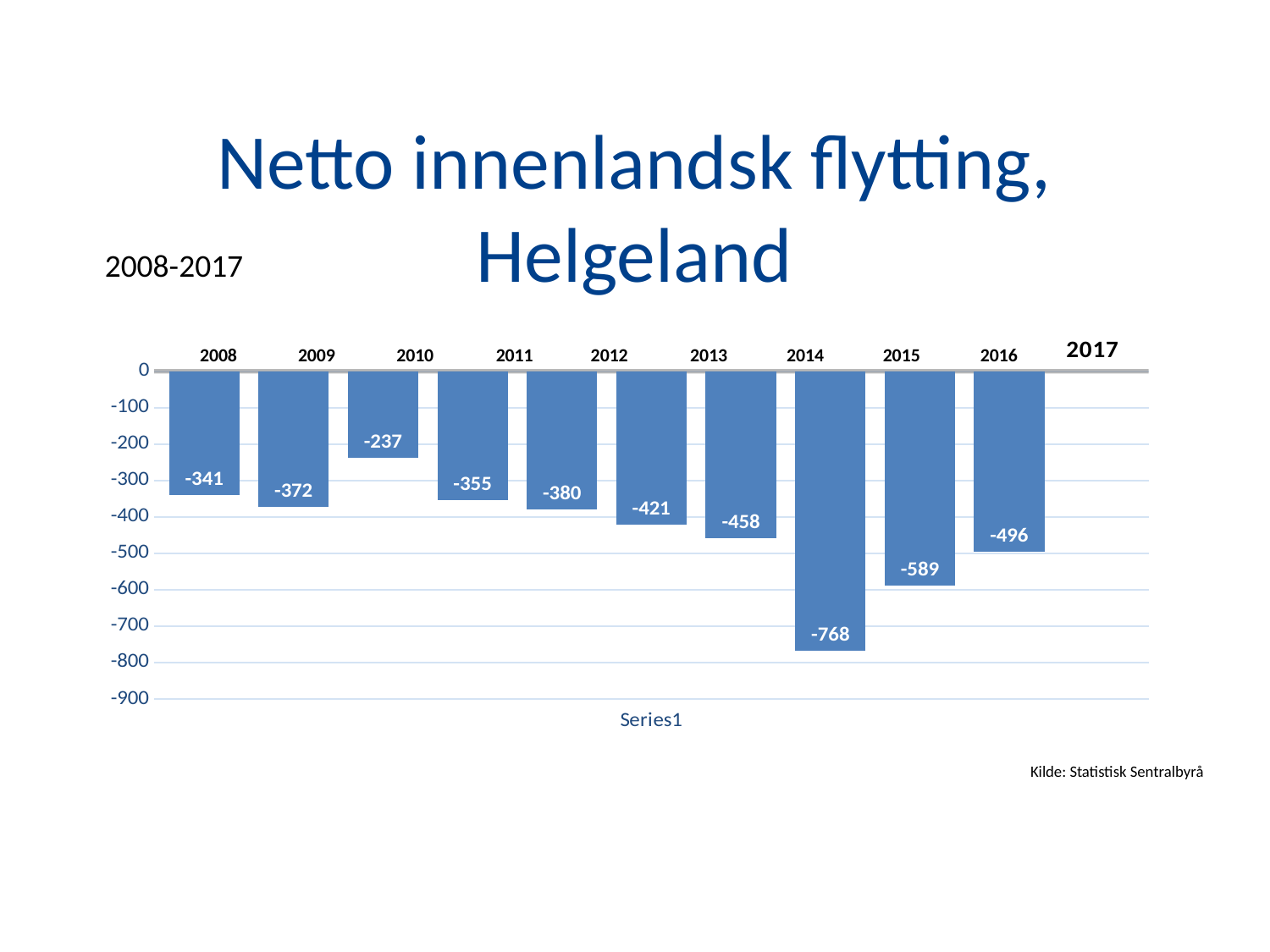
What is the value for 2010? -237 What kind of chart is shown on the slide? Bar chart What is the value for 2015? -768 Which year has the lowest (most negative) value? 2015 How many series does the legend list? 1 Which year has the highest (least negative) value? 2010 What is the title of the chart? Netto innenlandsk flytting, Helgeland How many years are shown on the x axis? 10 What is the value for 2017? -496 Which year has a more negative value, 2013 or 2014? 2014 What is the value for 2008? -341 What is the difference between the values for 2015 and 2016? 179